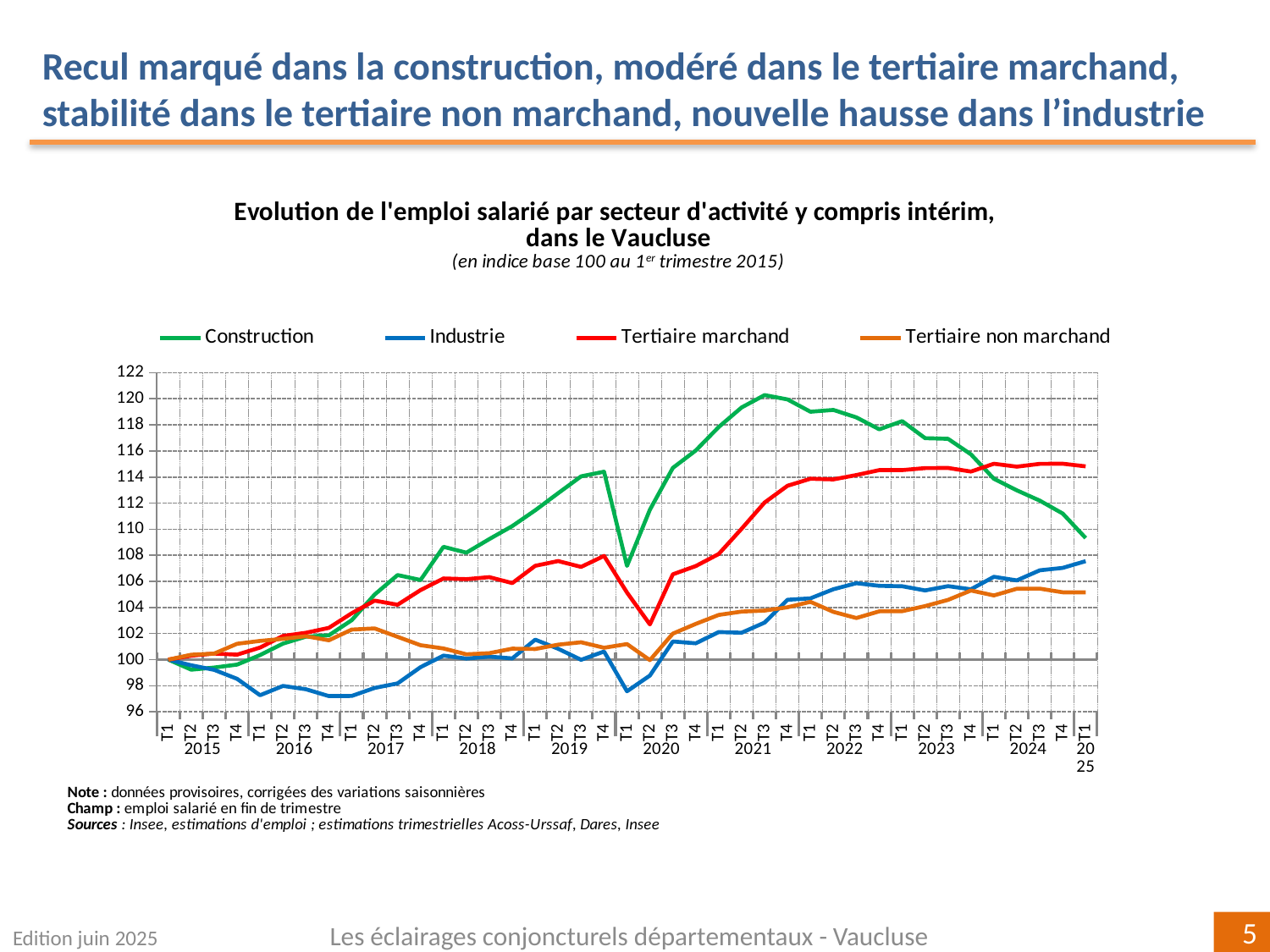
At T1 2025, which is larger: Tertiaire marchand or Tertiaire non marchand? Tertiaire marchand Which series falls to the lowest value anywhere on the chart? Industrie Which series reaches the highest value anywhere on the chart? Construction Does the Construction line rise or fall between T1 2023 and T1 2025? fall What colour is the Tertiaire marchand line? red Which series are listed in the legend? Construction, Industrie, Tertiaire marchand, Tertiaire non marchand Is the value for Tertiaire non marchand at T1 2025 greater or less than 104? greater Is the value for Construction at T1 2020 greater or less than 110? less Is the value for Construction at T3 2021 greater or less than 118? greater What kind of chart is shown on the slide? line chart How many series does the legend list? 4